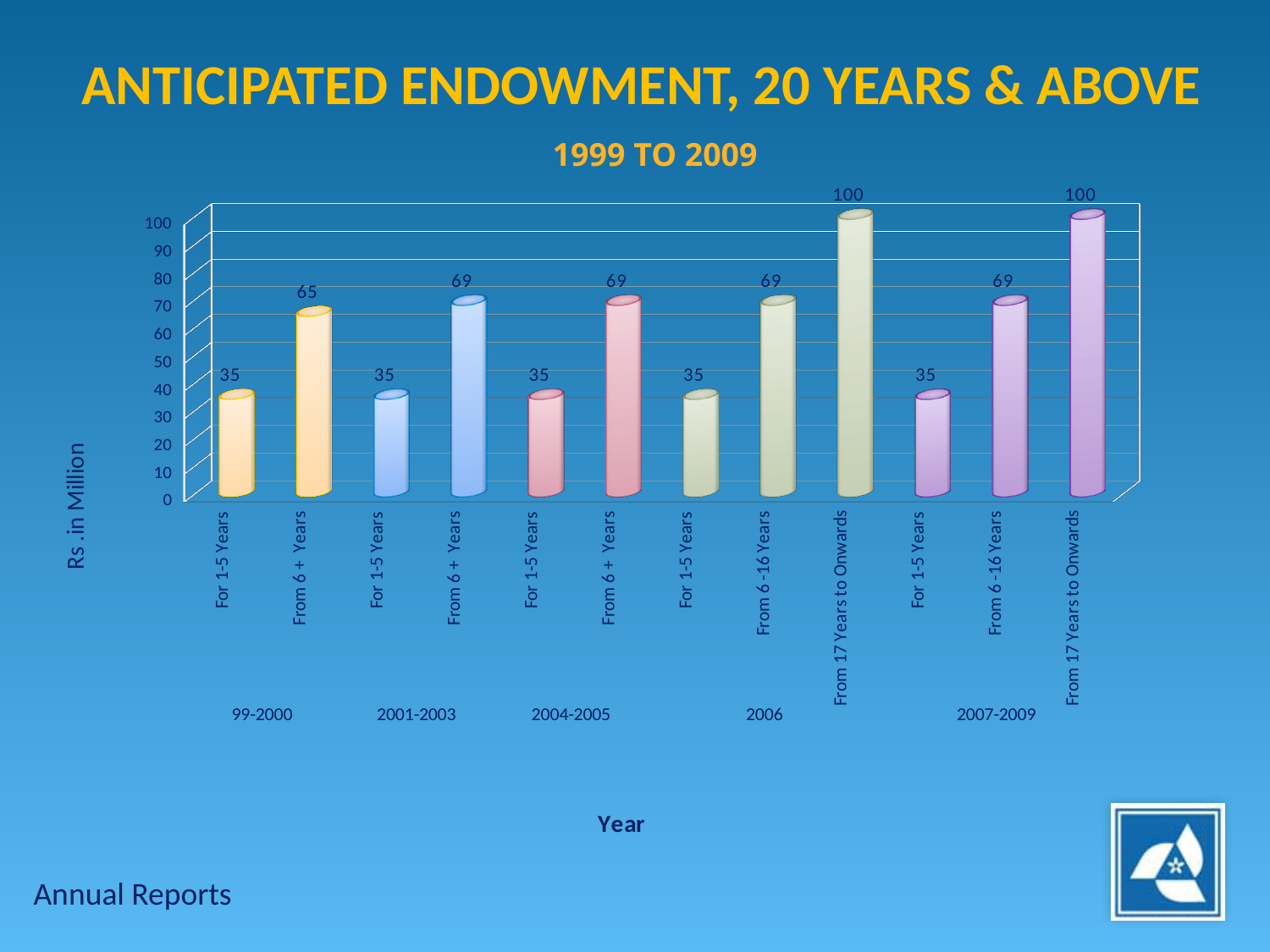
What is the difference between 'From 17 Years to Onwards' and 'From 6 -16 Years' in the 2006 group? 31 What kind of chart is shown on the slide? Bar chart What is the value for 'From 6 -16 Years' in the 2007-2009 group? 69 What is the value for 'From 6 + Years' in the 99-2000 group? 65 What is the lowest value shown on the chart? 35 What is the label of the vertical axis? Rs .in Million How many bars are plotted on the chart? 12 What is the value for 'From 17 Years to Onwards' in the 2006 group? 100 What is the value for 'For 1-5 Years' in the 2007-2009 group? 35 What is the difference between 'From 6 + Years' and 'For 1-5 Years' in the 2001-2003 group? 34 Which is larger: 'From 6 + Years' in 99-2000 or 'From 6 + Years' in 2001-2003? From 6 + Years in 2001-2003 What is the highest value shown on the chart? 100